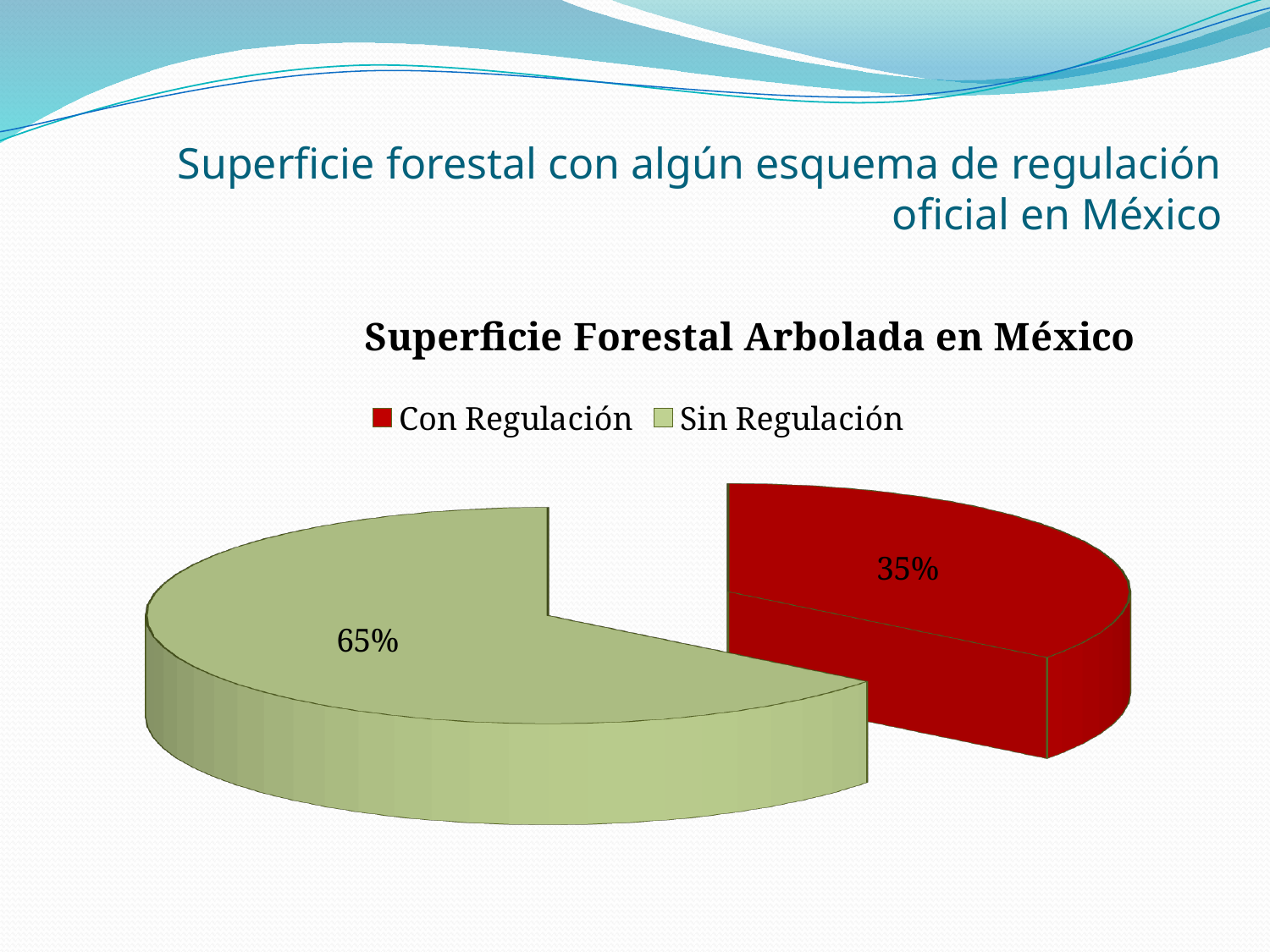
What percentage of the pie is labelled Sin Regulación? 65% Which slice is the largest in the pie chart? Sin Regulación Which is larger, the Con Regulación slice or the Sin Regulación slice? Sin Regulación What is the difference in percentage points between Sin Regulación and Con Regulación? 30 What percentage of the pie is labelled Con Regulación? 35% What type of chart is shown on the slide? Pie chart What is the title of the chart? Superficie Forestal Arbolada en México What colour is the Con Regulación slice? Red How many entries does the legend list? 2 What share of the pie does Sin Regulación represent? 65% How many slices does the pie chart have? 2 Which slice is the smallest in the pie chart? Con Regulación